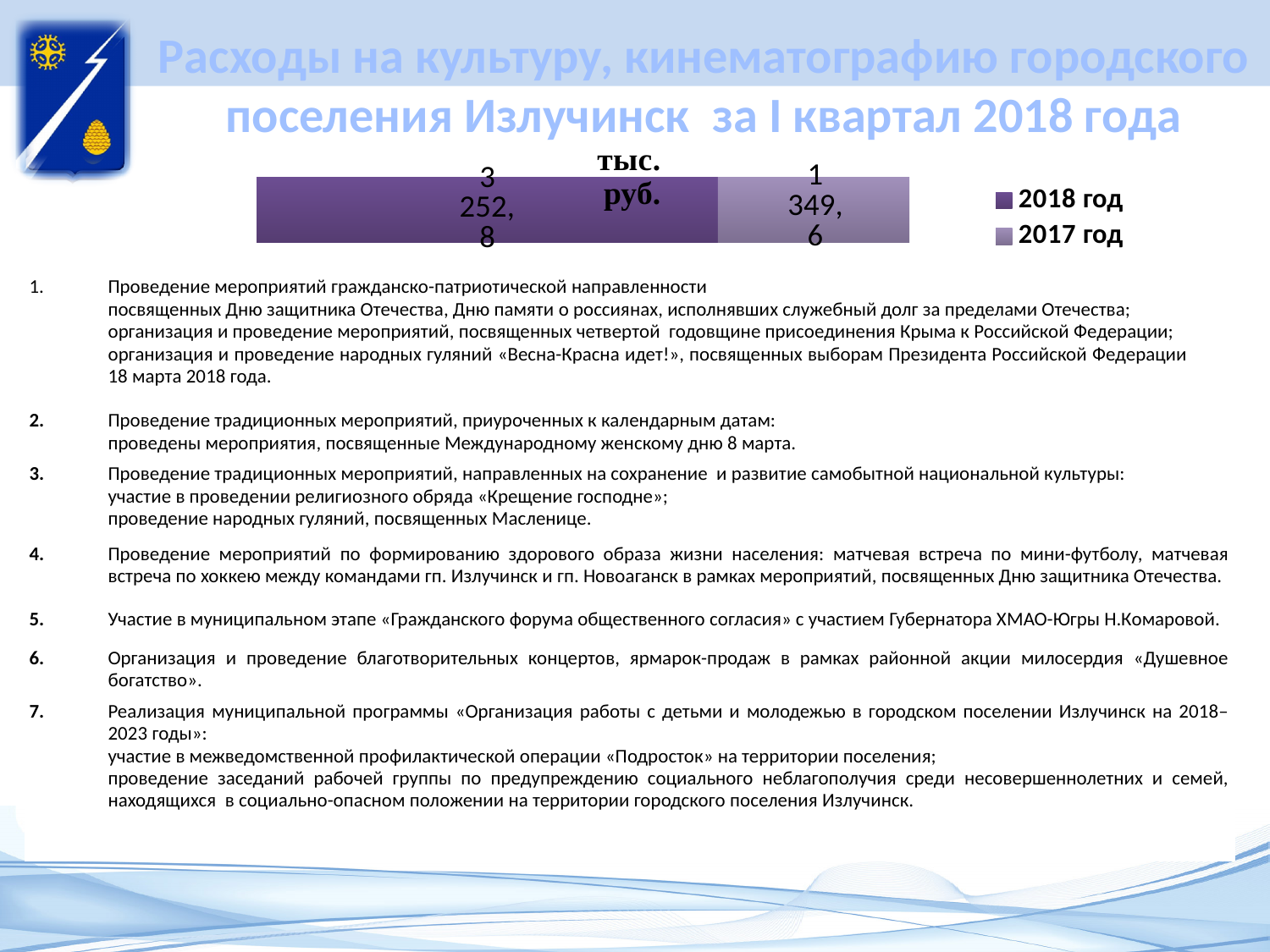
Which legend entry is shown in the darker purple colour? 2018 год What is the total of the two segments in the stacked bar? 4 602,4 How many series does the legend list? 2 What is the value for 2018 год in the chart? 3 252,8 What kind of chart is shown on the slide? Bar chart Which series has the highest value in the chart? 2018 год What is the value for 2017 год in the chart? 1 349,6 Which series has the lowest value in the chart? 2017 год What unit label is shown on the chart? тыс. руб. What is the difference between the values for 2018 год and 2017 год? 1 903,2 Which year has the larger value in the chart, 2018 год or 2017 год? 2018 год